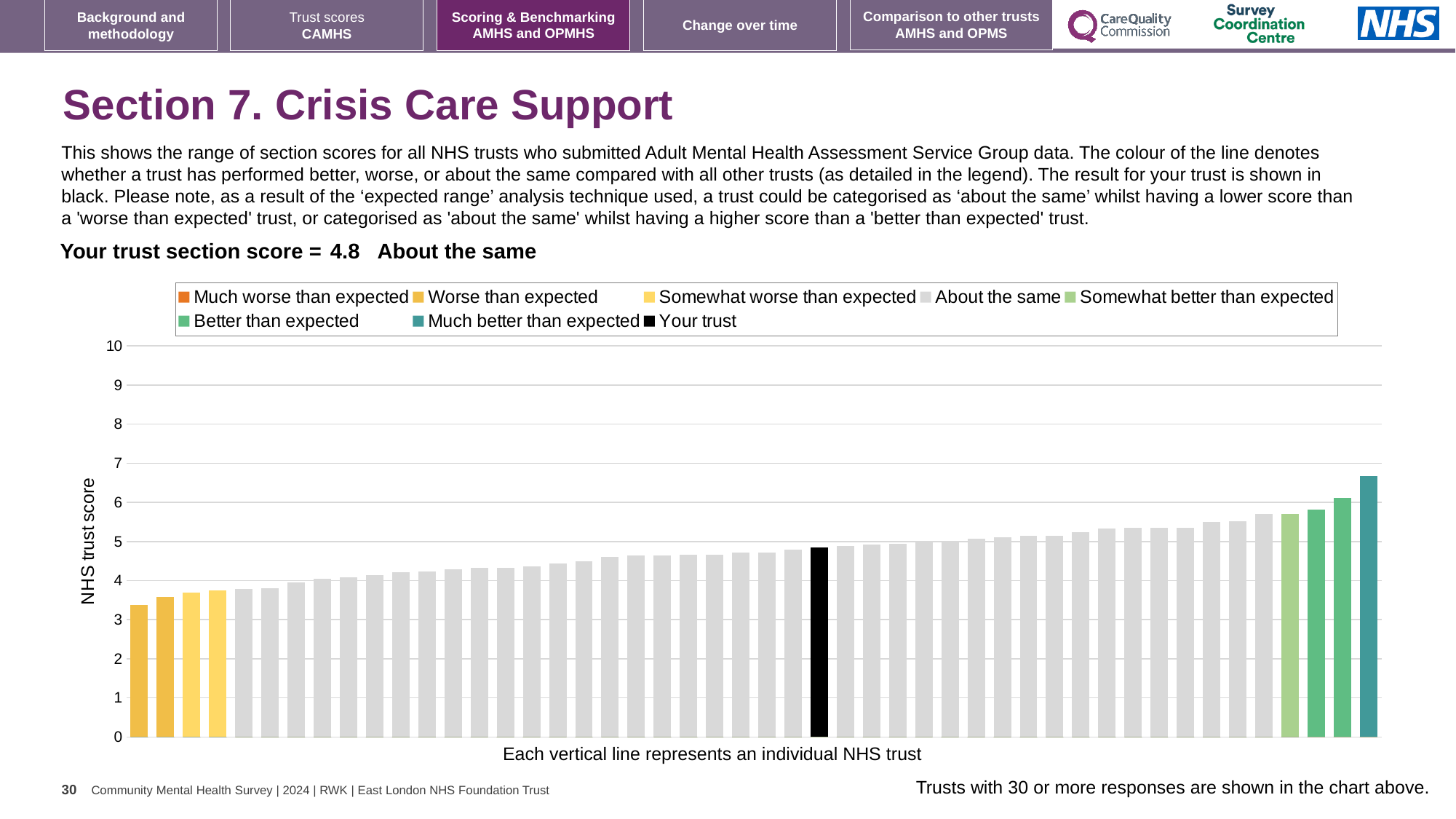
Is the value of the tallest bar in the chart greater or less than 6? greater Which is higher: the black bar for your trust or the leftmost bar in the chart? the black bar for your trust Is the value of the shortest bar in the chart greater or less than 4? less Do the bar values rise or fall from left to right across the chart? rise What is the label on the vertical axis of the chart? NHS trust score Which legend category does the shortest bar in the chart belong to? Worse than expected Which category is your trust's section score placed in? About the same What kind of chart is shown on the slide? bar chart Is the value for your trust (the black bar) greater or less than 5? less Which legend category does the tallest bar in the chart belong to? Much better than expected How many entries does the chart legend list? 8 What is the section score for your trust shown on the slide? 4.8